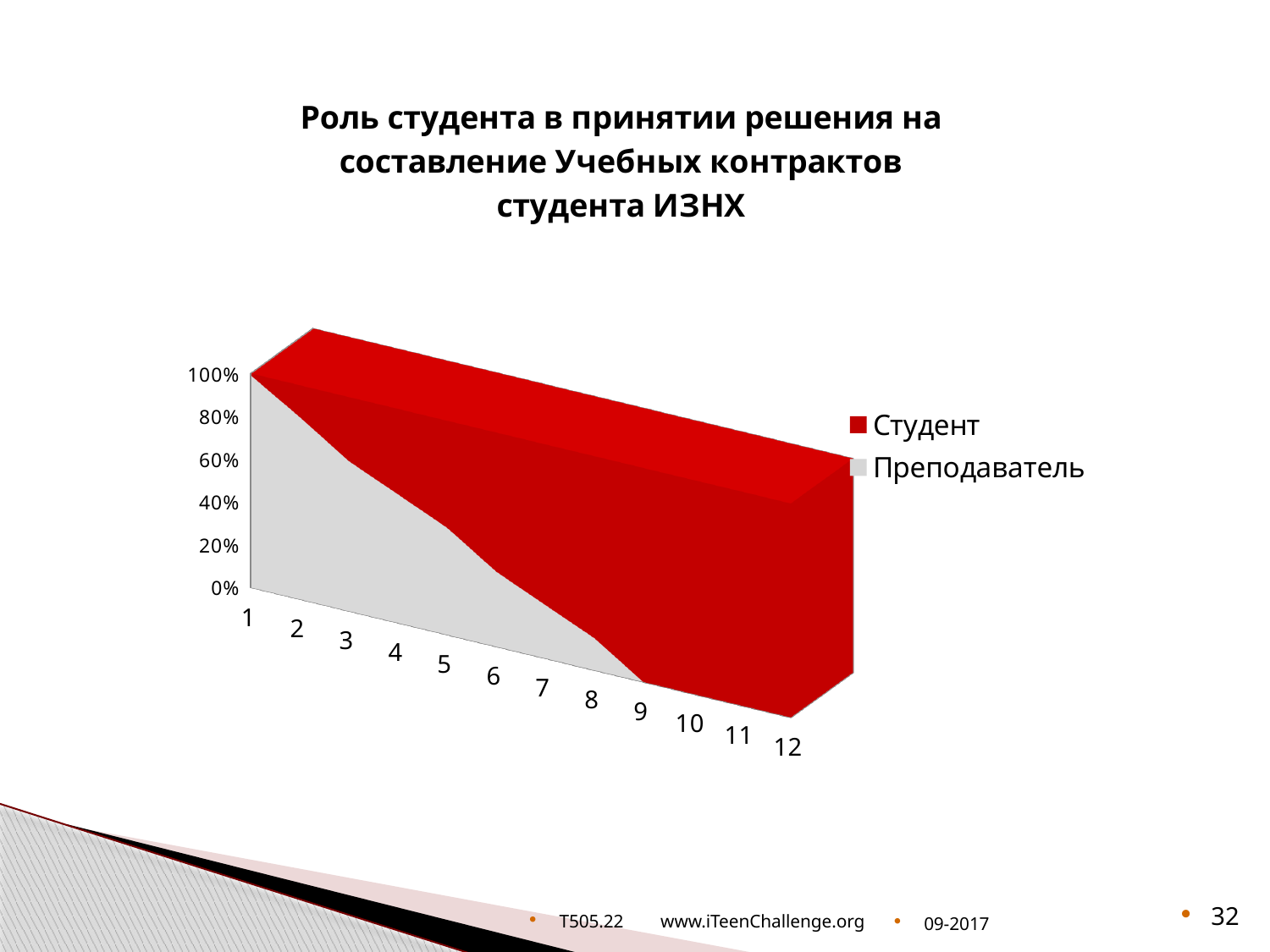
Which colour represents the Студент series in the chart? red Does the share of Преподаватель rise or fall as the categories go from 1 to 12? fall Does the share of Студент rise or fall as the categories go from 1 to 12? rise What kind of chart is shown on the slide? area chart Is the value for Преподаватель at category 1 greater or less than 80%? greater How many categories are shown along the x axis of the chart? 12 What are the two series named in the chart's legend? Студент, Преподаватель At category 12, which series has the larger share, Студент or Преподаватель? Студент At category 1, which series has the larger share, Студент or Преподаватель? Преподаватель How many series does the chart's legend list? 2 Is the value for Студент at category 12 greater or less than 80%? greater Is the value for Преподаватель at category 12 greater or less than 20%? less